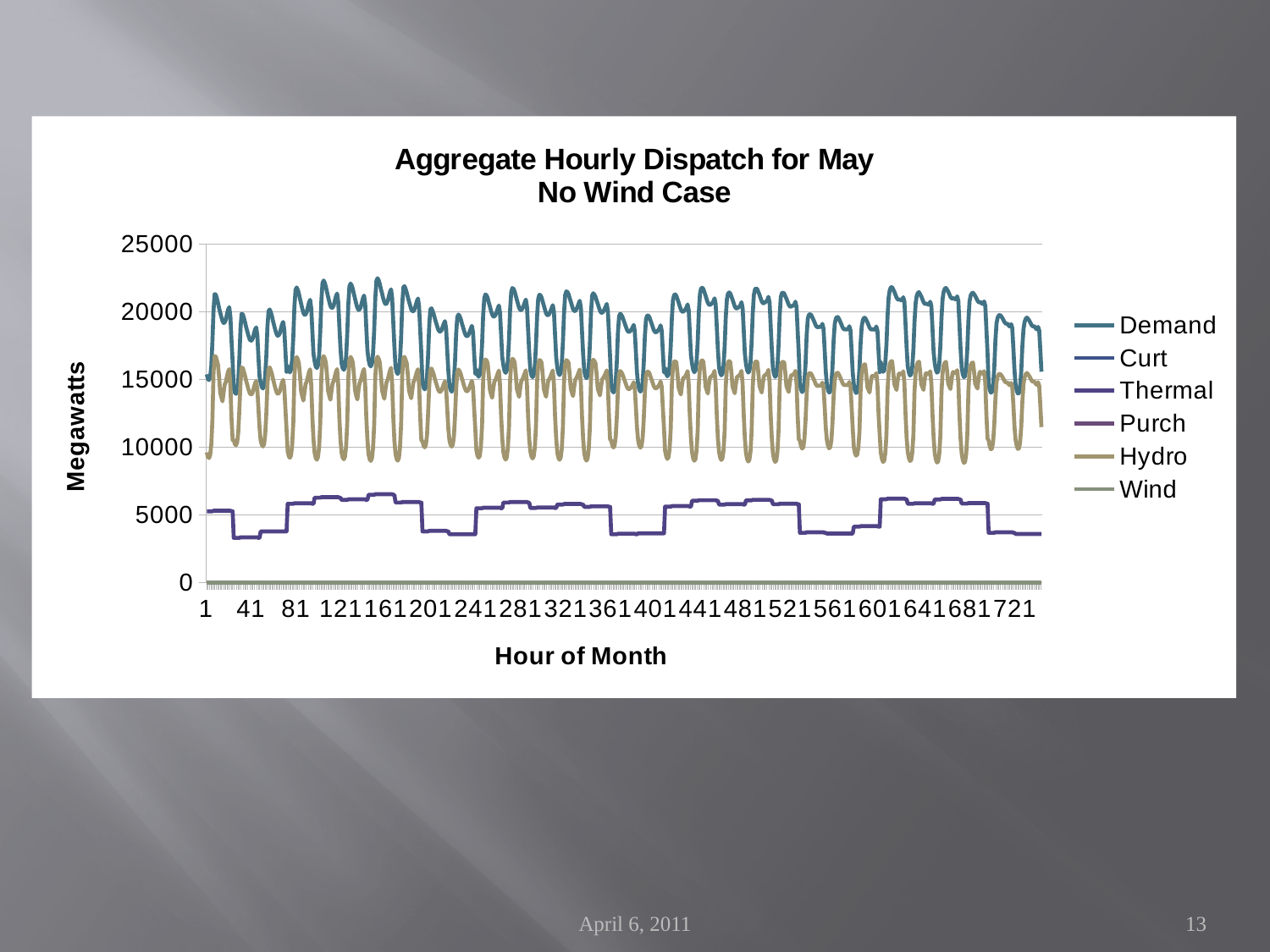
Is the value of the Demand series at hour 1 greater or less than 10000? greater Is the value of the Thermal series at hour 41 greater or less than 10000? less What is the title of the chart? Aggregate Hourly Dispatch for May No Wind Case What is the label of the vertical axis? Megawatts Is the Demand series larger or smaller than the Thermal series at hour 1? larger Is the value of the Hydro series at hour 1 greater or less than 5000? greater What kind of chart is shown on the slide? line chart Is the Hydro series larger or smaller than the Demand series at hour 401? smaller Which series has the highest values throughout the month? Demand How many series does the legend list? 6